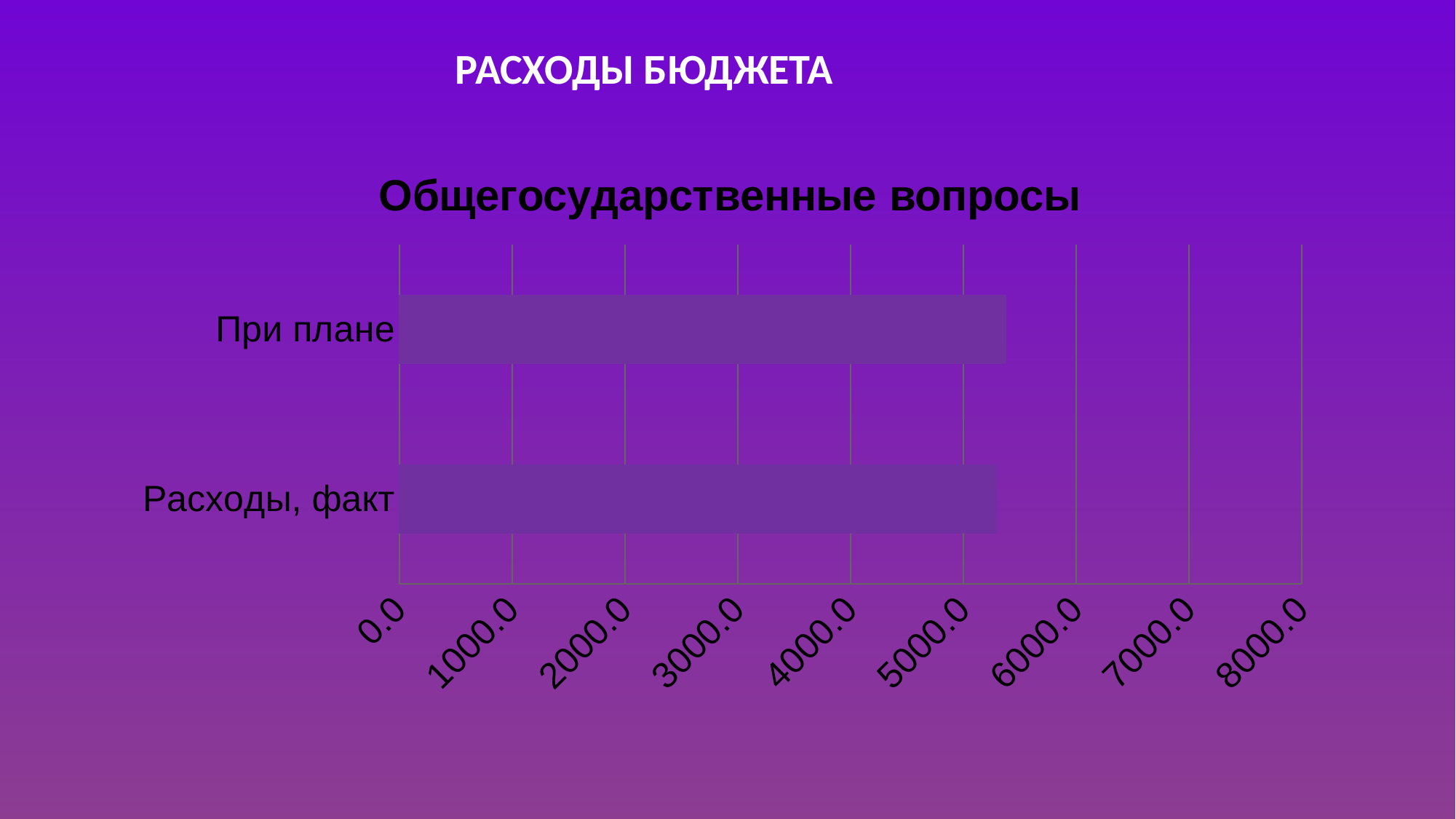
Is the value for Расходы, факт greater or less than 5000.0? greater What kind of chart is shown on the slide? bar chart What is the highest value shown on the horizontal axis of the chart? 8000.0 Is the value for При плане greater or less than 6000.0? less Is the value for Расходы, факт greater or less than 6000.0? less What is the title of the chart? Общегосударственные вопросы How many categories are plotted in the chart? 2